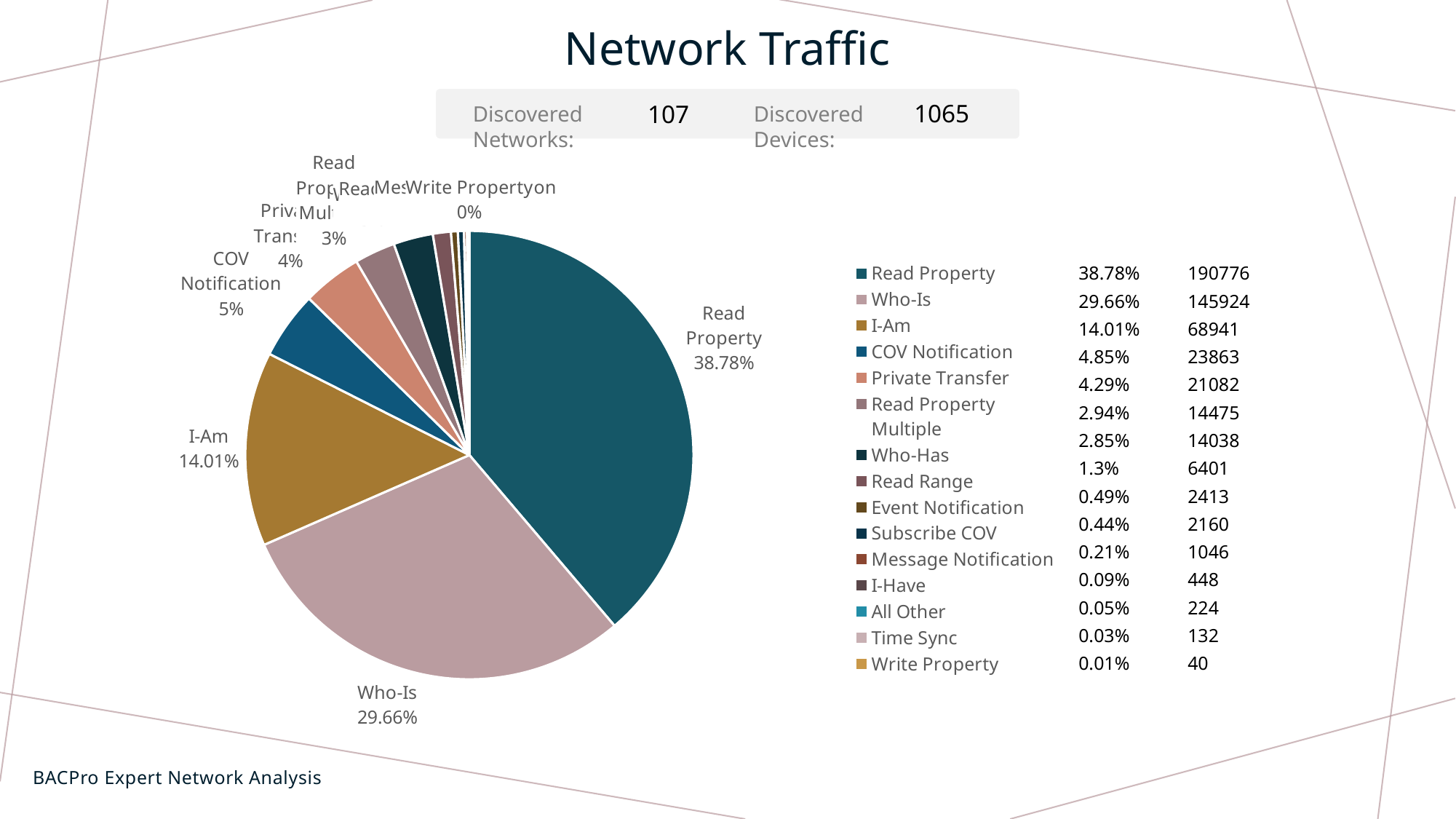
What is the difference in percentage points between the Read Property share and the Who-Is share? 9.12% Which category has the smallest share of network traffic in the legend? Write Property What percentage of network traffic is I-Am? 14.01% Which category has the largest share of network traffic? Read Property How many categories are listed in the chart legend? 15 What kind of chart is shown on the slide? pie chart What percentage of network traffic is Who-Is? 29.66% What is the count shown for Read Property in the legend? 190776 Which has a larger share of network traffic, Who-Is or I-Am? Who-Is What percentage of network traffic is COV Notification according to the legend? 4.85% What is the title of the chart? Network Traffic What percentage of network traffic is Read Property according to the legend? 38.78%